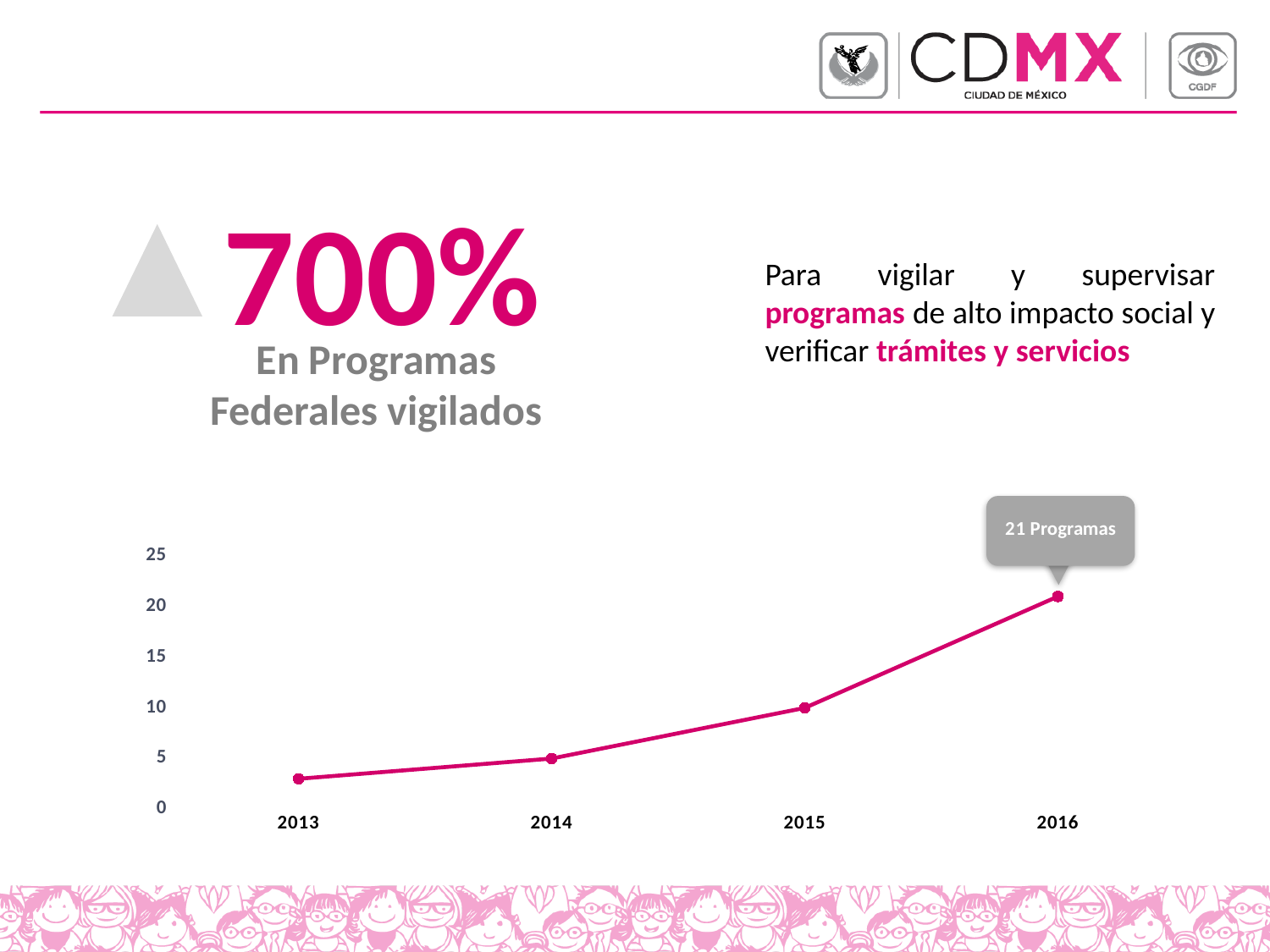
Is the value for 2013 greater or less than 5? less What kind of chart is shown on the slide? line chart Which year has the larger value, 2014 or 2015? 2015 Is the value for 2014 greater or less than 10? less Which year has the highest value on the chart? 2016 Is the value for 2015 greater or less than 5? greater Which year has the lowest value on the chart? 2013 How many years are plotted along the x axis of the chart? 4 Do the values rise or fall from 2013 to 2016? rise What value is labelled for 2016 on the chart? 21 Programas What is the first year shown on the x axis of the chart? 2013